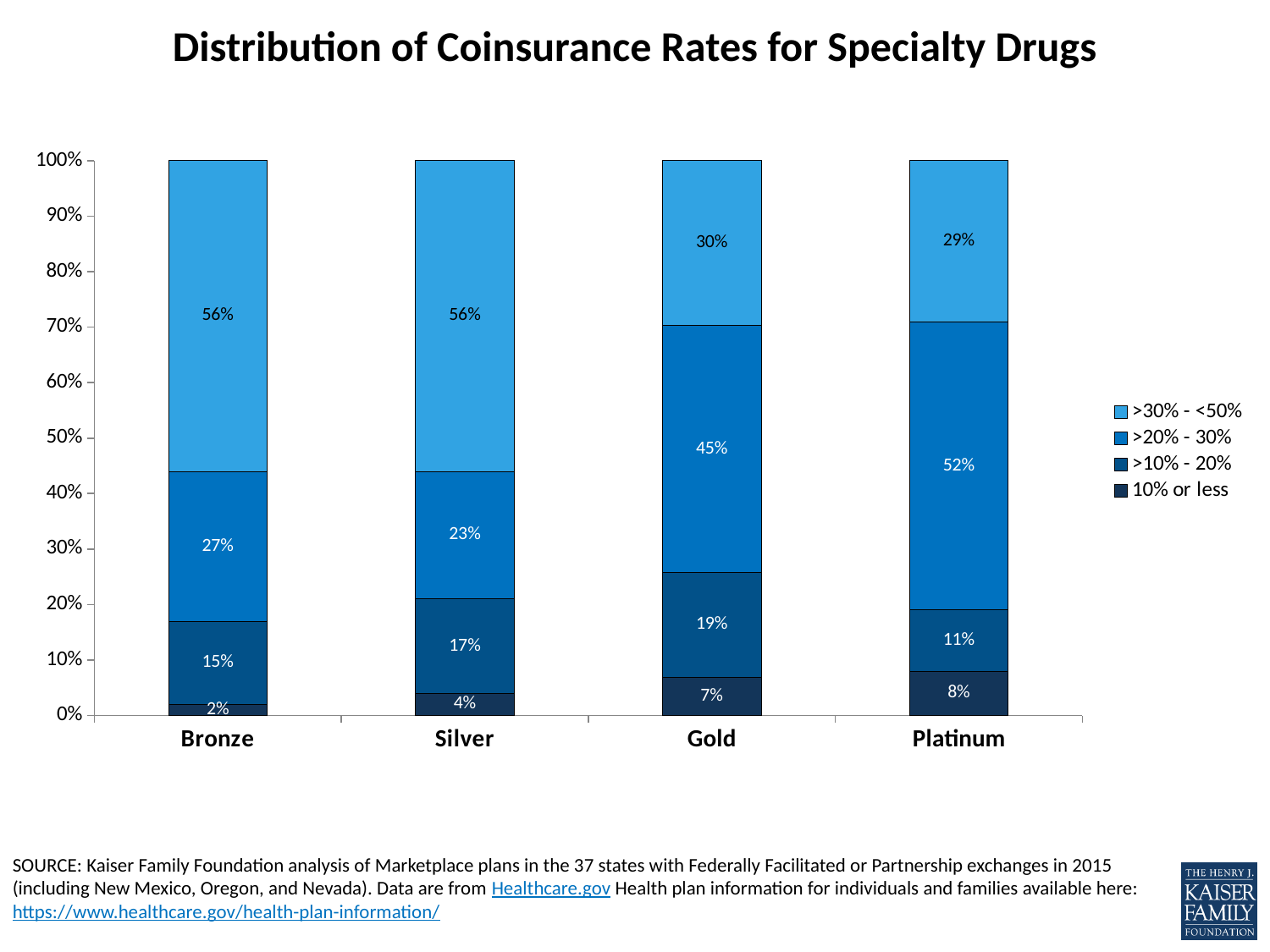
Which plan category has the highest value for the '>20% - 30%' segment? Platinum How many plan categories are shown on the x axis? 4 What is the title of the chart? Distribution of Coinsurance Rates for Specialty Drugs What is the value of the '>20% - 30%' segment for Gold? 45% How many series does the legend list? 4 Which plan category has the lowest value for the '10% or less' segment? Bronze What is the value of the '10% or less' segment for Platinum? 8% What type of chart is shown on the slide? Stacked bar chart What is the difference between the '>10% - 20%' segment for Gold and for Platinum? 8% Does the '10% or less' segment for Bronze, Silver, Gold and Platinum rise or fall from left to right? Rise Which is larger: the '>30% - <50%' segment for Gold or for Platinum? Gold What is the value of the '>30% - <50%' segment for Silver? 56%